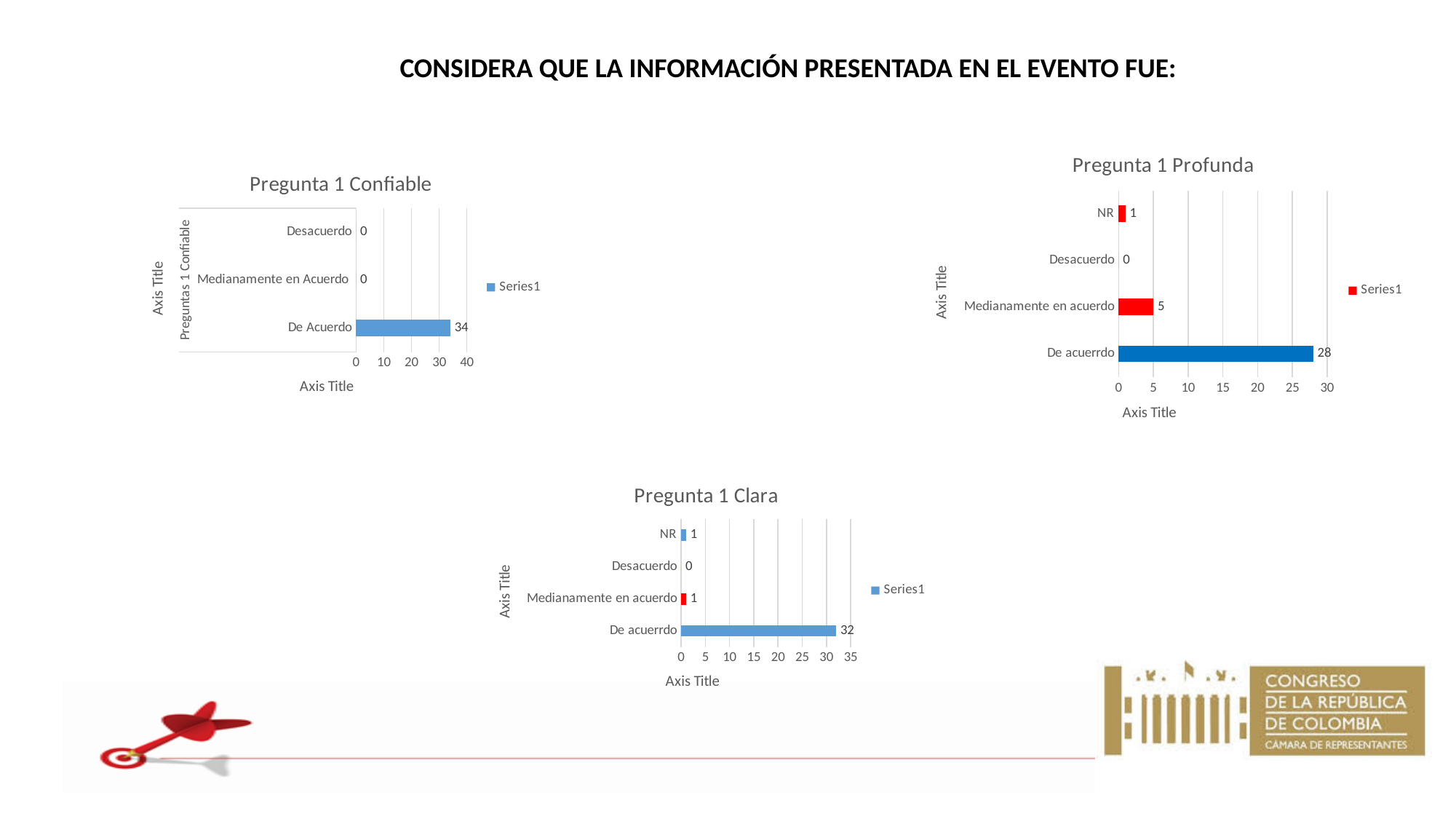
Which is larger: De Acuerdo in the 'Pregunta 1 Confiable' chart or De acuerrdo in the 'Pregunta 1 Profunda' chart? De Acuerdo in Pregunta 1 Confiable In the 'Pregunta 1 Confiable' chart, what is the value for De Acuerdo? 34 In the 'Pregunta 1 Profunda' chart, which category has the highest value? De acuerrdo In the 'Pregunta 1 Clara' chart, what is the value for De acuerrdo? 32 In the 'Pregunta 1 Profunda' chart, what is the value for Medianamente en acuerdo? 5 How many series does the legend of the 'Pregunta 1 Profunda' chart list? 1 How many categories are shown in the 'Pregunta 1 Clara' chart? 4 In the 'Pregunta 1 Clara' chart, what is the difference between De acuerrdo and NR? 31 What is the title of the chart at the top right of the slide? Pregunta 1 Profunda How many categories are shown in the 'Pregunta 1 Confiable' chart? 3 What kind of chart is 'Pregunta 1 Clara'? Bar chart In the 'Pregunta 1 Profunda' chart, what is the difference between De acuerrdo and Medianamente en acuerdo? 23